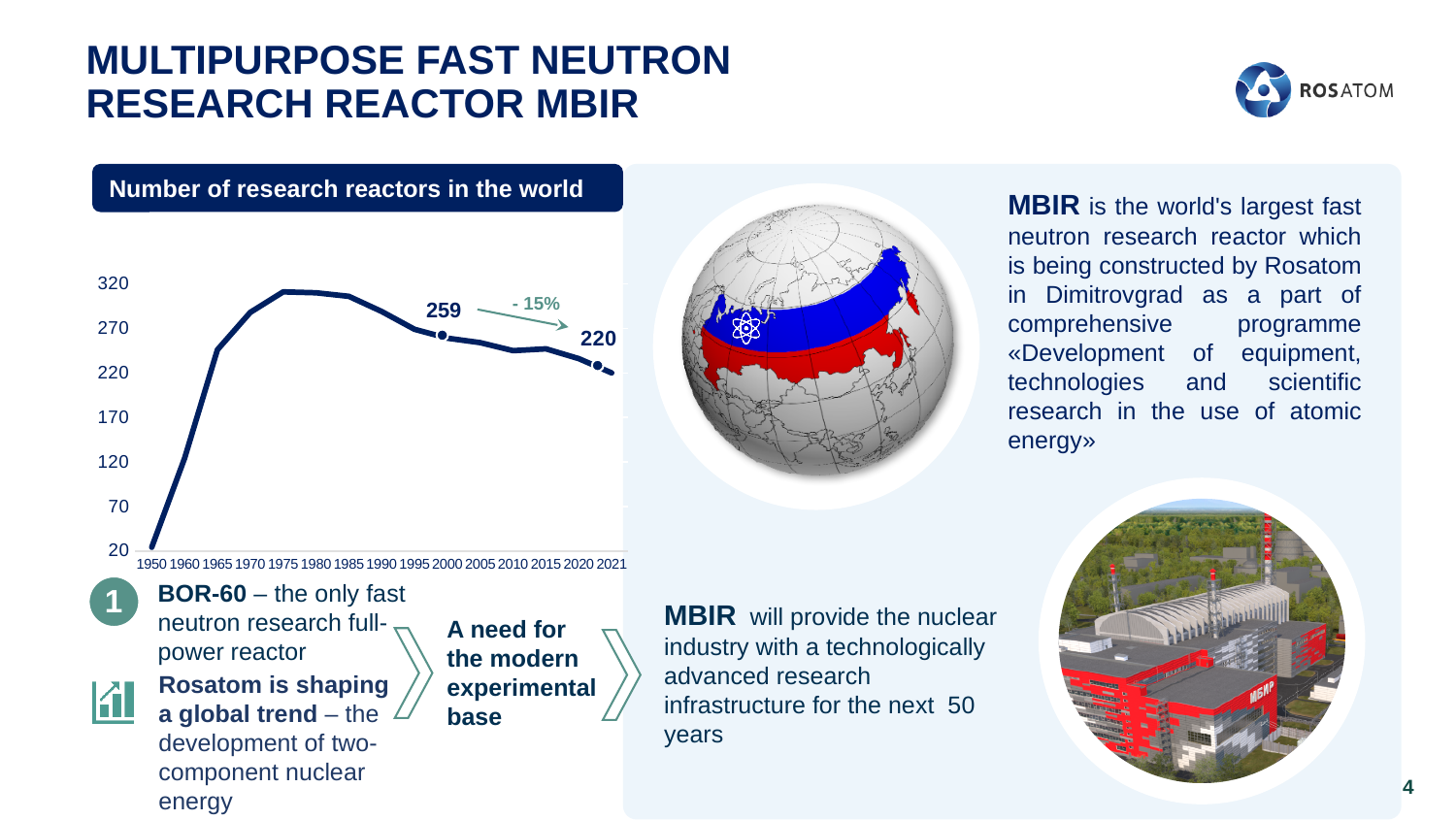
Is the value for 1960 greater or less than 170? less Is the value for 1975 greater or less than 270? greater Which year has the larger value, 1975 or 2021? 1975 What is the title of the chart? Number of research reactors in the world What is the number of research reactors in the world shown for 2021? 220 Does the number of research reactors rise or fall between 1950 and 1975? rise Is the value for 1950 greater or less than 70? less What is the earlier labelled value on the line, before the decline to 220? 259 What is the difference between the two labelled values, 259 and 220? 39 What percentage change is annotated on the chart between the 259 and 220 points? - 15% Does the number of research reactors rise or fall between 1985 and 2021? fall What kind of chart is shown on the slide? line chart